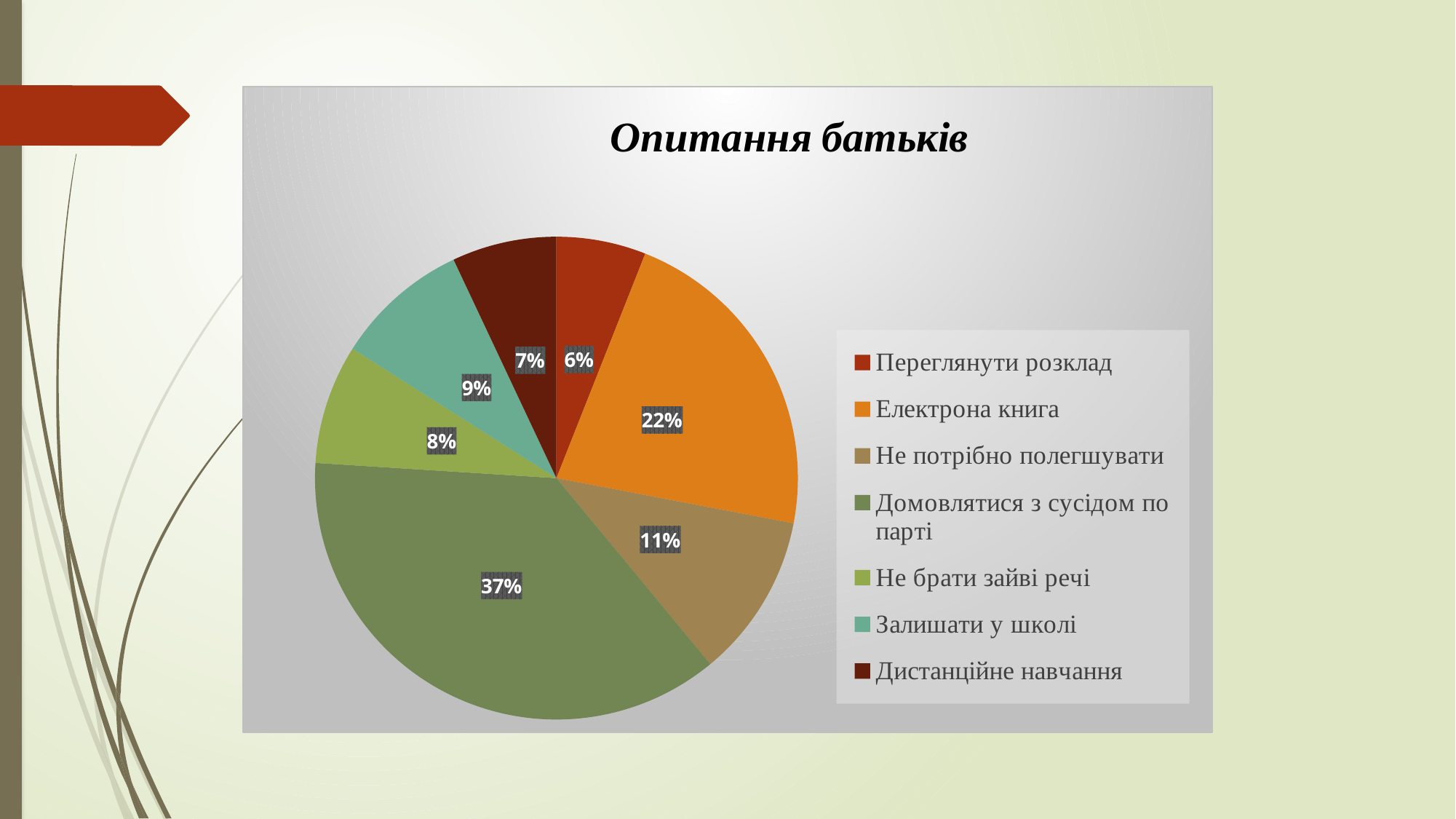
What type of chart is shown on the slide? pie chart What is the difference in percentage points between "Електрона книга" and "Не брати зайві речі"? 14 Which is larger, the share for "Залишати у школі" or the share for "Переглянути розклад"? Залишати у школі What percentage is shown for "Електрона книга"? 22% Which category has the smallest share of the pie? Переглянути розклад What percentage is shown for "Дистанційне навчання"? 7% What is the title of the chart? Опитання батьків What percentage is shown for "Залишати у школі"? 9% What percentage is shown for "Домовлятися з сусідом по парті"? 37% Which category has the largest share of the pie? Домовлятися з сусідом по парті What percentage is shown for "Не потрібно полегшувати"? 11% How many slices does the pie chart have? 7